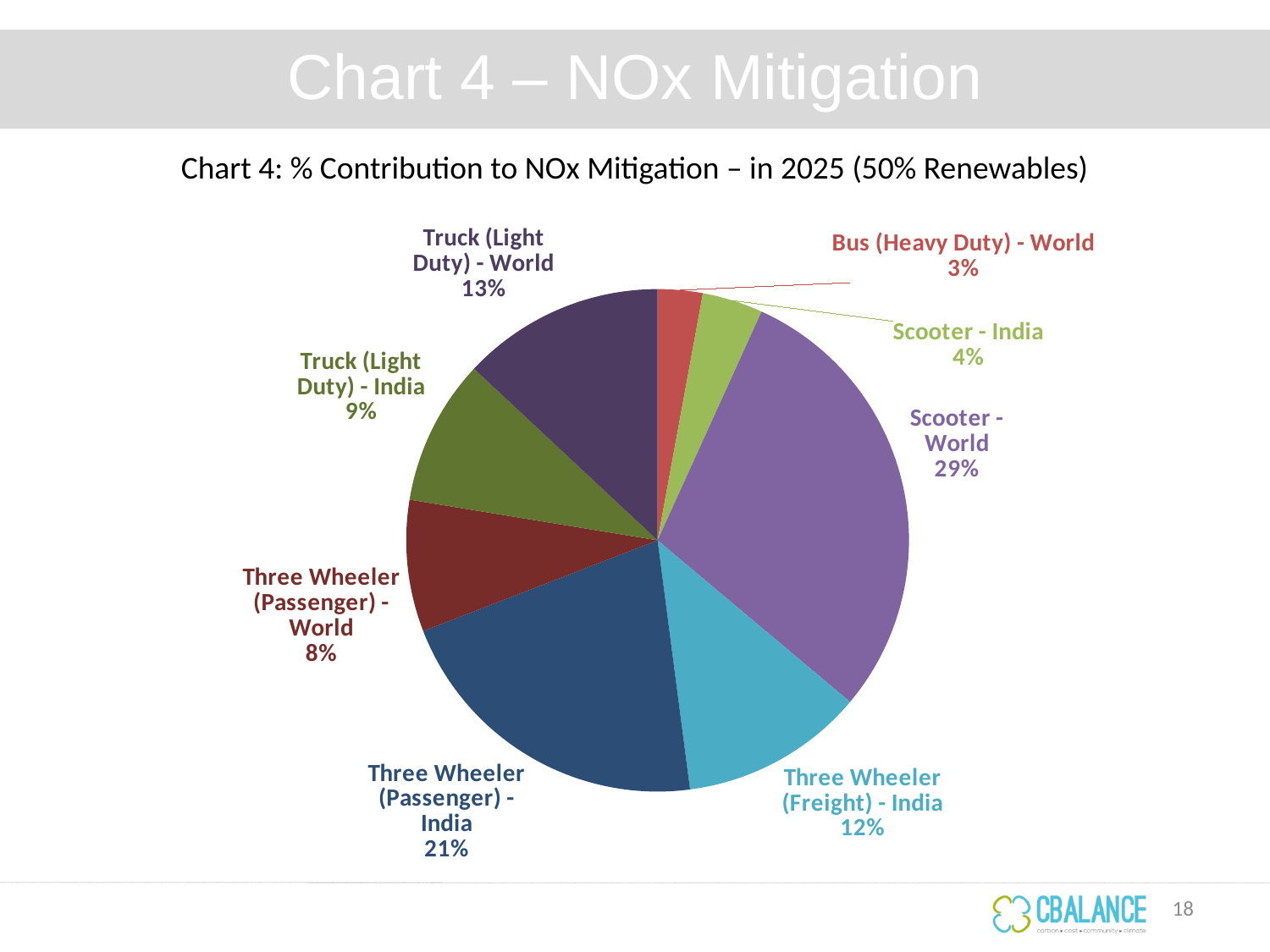
What kind of chart is shown on the slide? Pie chart Which category has the smallest slice of the pie? Bus (Heavy Duty) - World What is the difference between the shares of Three Wheeler (Passenger) - India and Three Wheeler (Freight) - India? 9% How many categories are shown in the pie chart? 8 Which is larger, the share for Truck (Light Duty) - India or the share for Three Wheeler (Passenger) - World? Truck (Light Duty) - India What share of NOx mitigation is contributed by Scooter - World? 29% What is the value shown for Truck (Light Duty) - World? 13% Which category has the largest slice of the pie? Scooter - World What is the title of the chart? Chart 4: % Contribution to NOx Mitigation – in 2025 (50% Renewables) What is the value shown for Three Wheeler (Passenger) - India? 21% What is the value shown for Bus (Heavy Duty) - World? 3% What is the difference between the shares of Scooter - World and Scooter - India? 25%